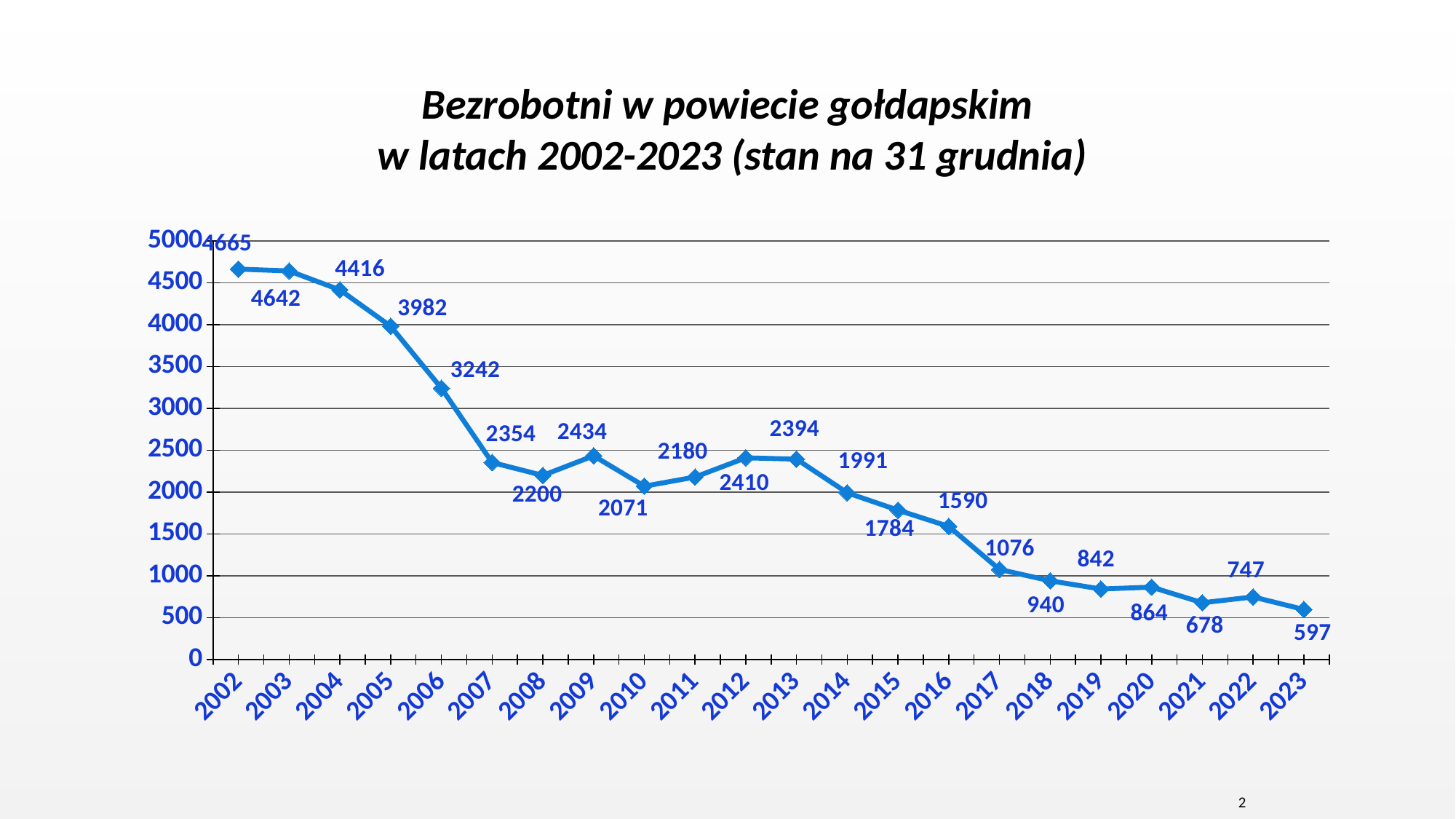
Which year has the lowest value? 2023 What is the title of the chart? Bezrobotni w powiecie gołdapskim w latach 2002-2023 (stan na 31 grudnia) What is the value for 2017? 1076 What type of chart is shown on the slide? line chart What is the number of unemployed in 2006? 3242 Which is larger, the value for 2009 or the value for 2012? 2009 What is the value for 2023? 597 Which year has the highest value? 2002 How many years are plotted on the x axis? 22 Do the values generally rise or fall from 2002 to 2023? fall What is the difference between the values for 2005 and 2006? 740 What is the value for 2013? 2394